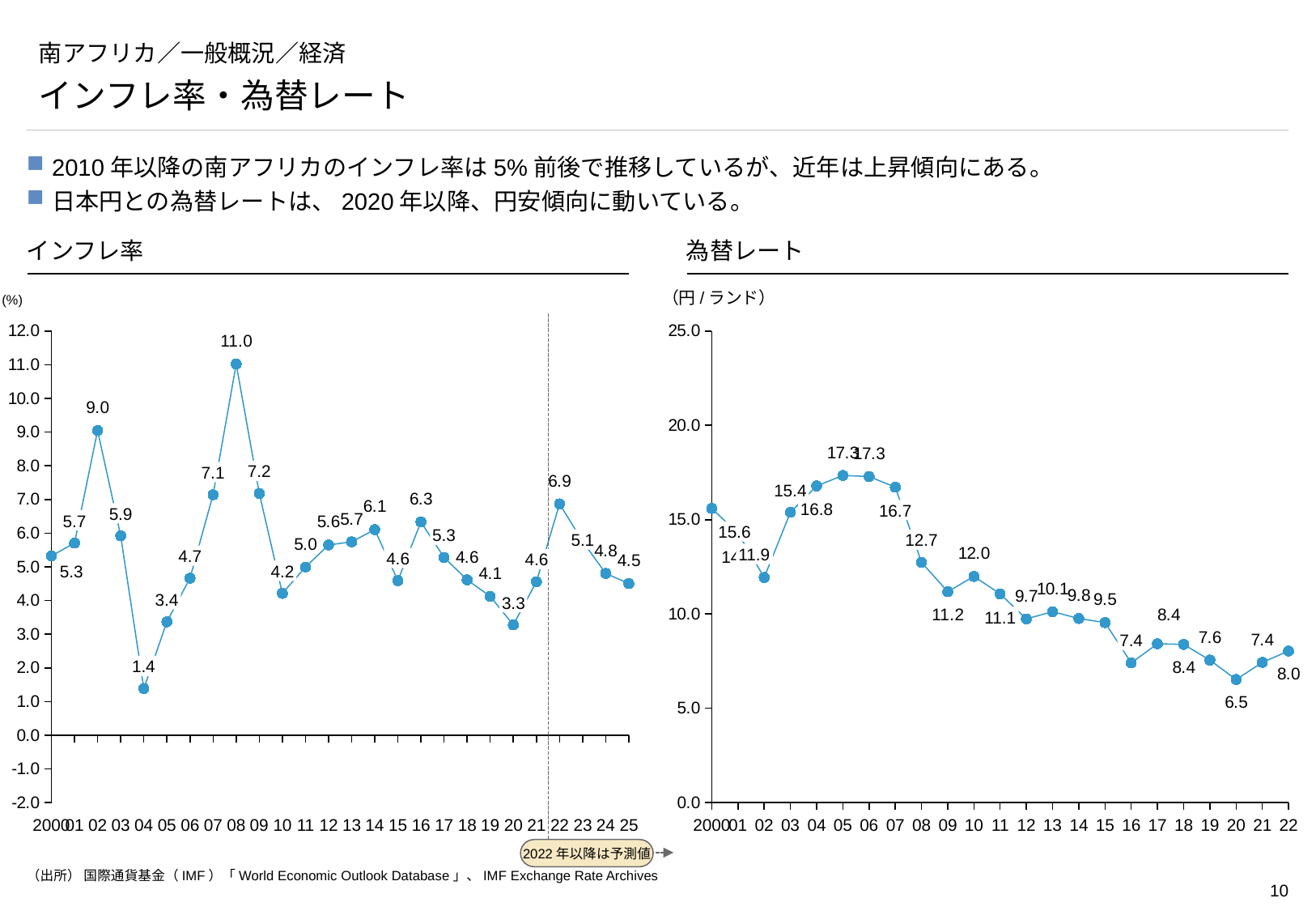
In the 為替レート chart, what is the difference between the 2005 value and the 2022 value? 9.3 In the インフレ率 chart, what is the difference between the 2022 value and the 2020 value? 3.6 What type of chart is the インフレ率 chart? line chart In the インフレ率 chart, what is the inflation rate for 2008? 11.0 In the 為替レート chart, which year has the lowest value? 2020 What unit is shown on the y axis of the 為替レート chart? 円/ランド In the インフレ率 chart, which year has the lowest inflation rate? 2004 In the インフレ率 chart, which is larger, the value for 2002 or the value for 2009? 2002 In the 為替レート chart, is the value for 2010 greater or less than 10.0? greater In the 為替レート chart, do the values generally rise or fall from 2007 to 2020? fall In the 為替レート chart, what is the value for 2020? 6.5 In the インフレ率 chart, what is the inflation rate for 2025? 4.5